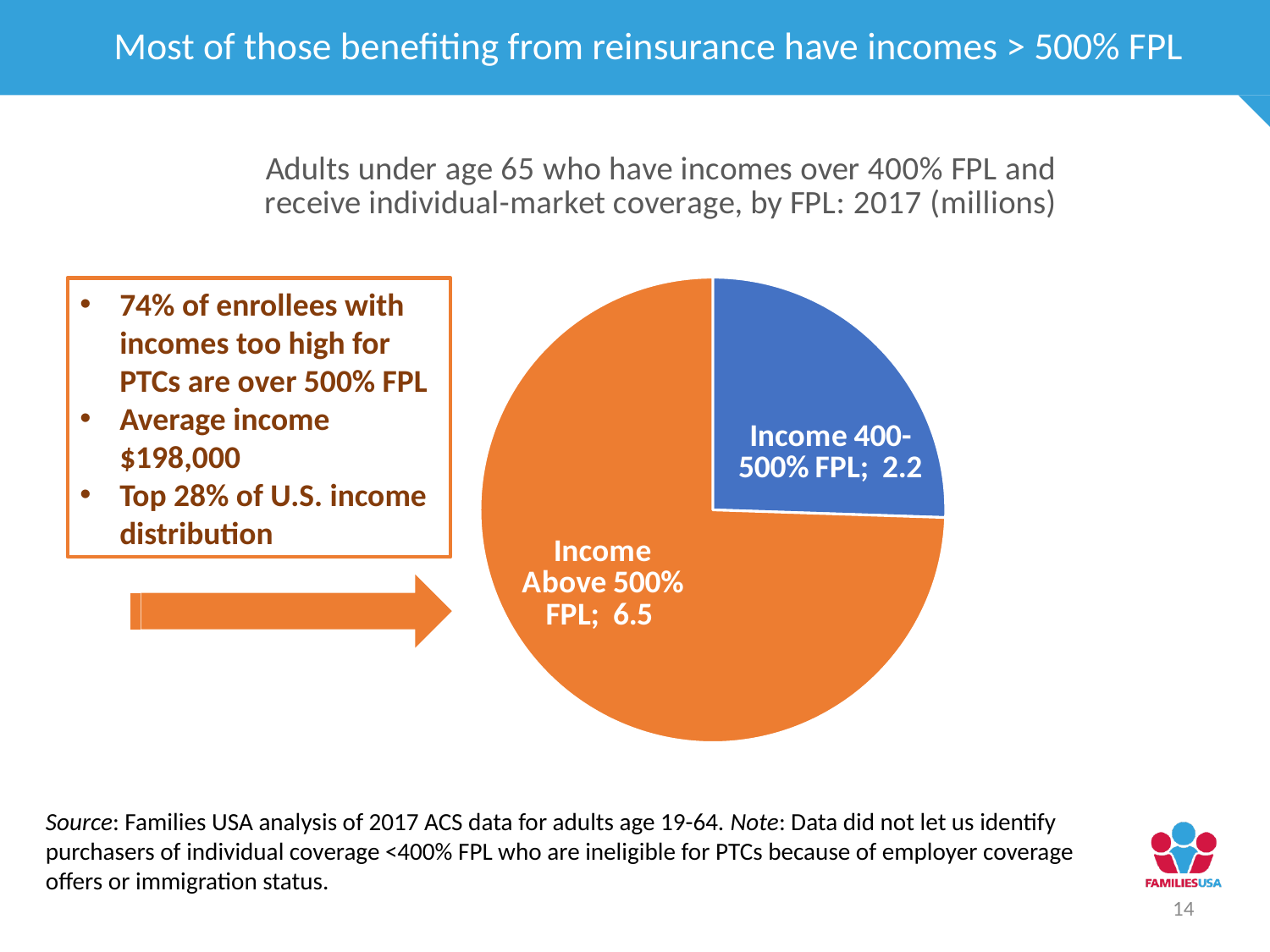
What is the value for the Income Above 500% FPL slice? 6.5 What colour is the Income Above 500% FPL slice? Orange What is the total of the two pie chart values? 8.7 Which is larger: the value for Income Above 500% FPL or the value for Income 400-500% FPL? Income Above 500% FPL What is the difference between the Income Above 500% FPL value and the Income 400-500% FPL value? 4.3 What type of chart is shown on the slide? Pie chart How many slices does the pie chart have? 2 What is the value for the Income 400-500% FPL slice? 2.2 What is the title of the chart? Adults under age 65 who have incomes over 400% FPL and receive individual-market coverage, by FPL: 2017 (millions) Which slice of the pie chart is the smallest? Income 400-500% FPL Which slice of the pie chart is the largest? Income Above 500% FPL